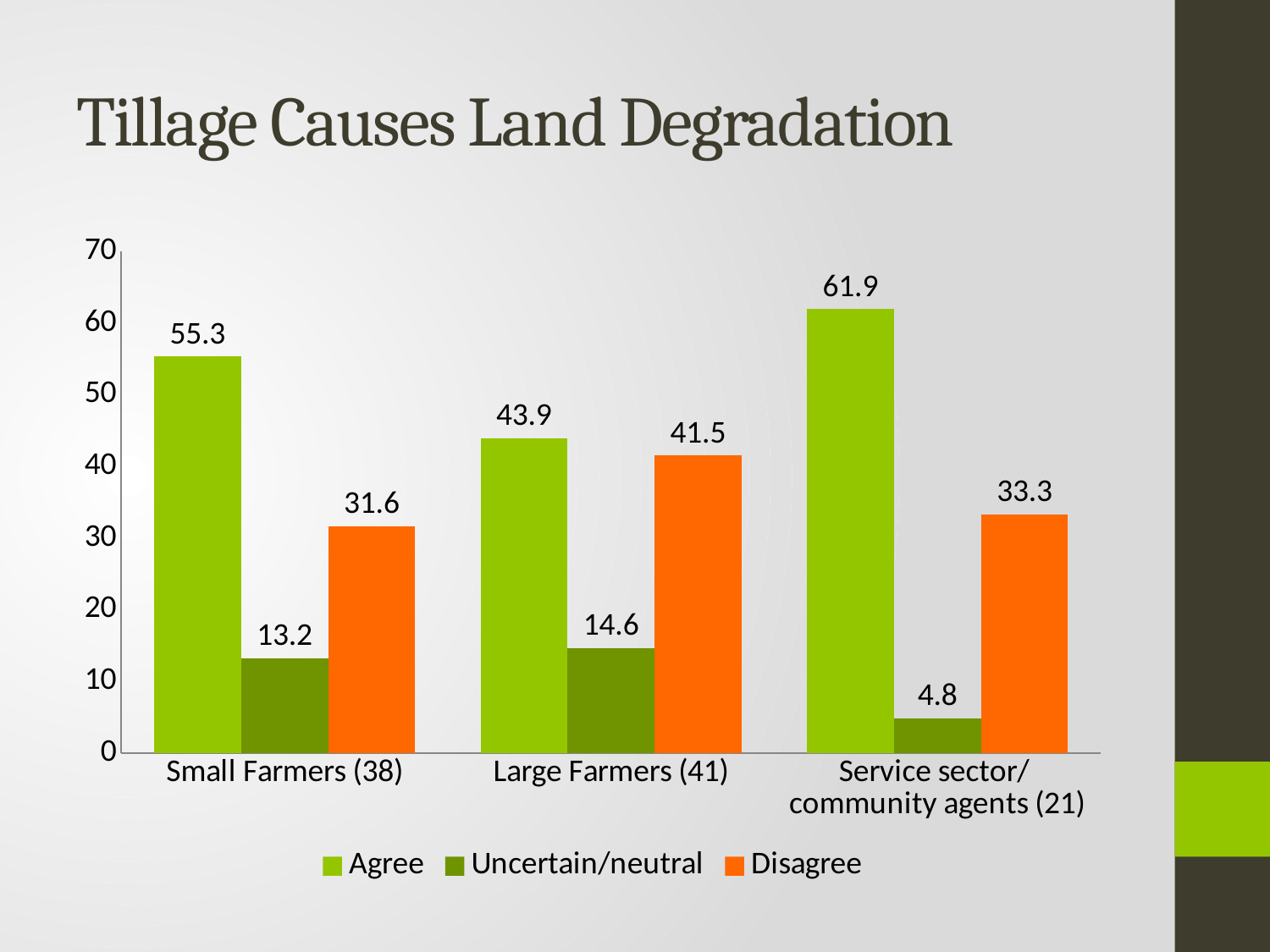
What is the Agree value for Small Farmers (38)? 55.3 How many categories are shown on the x axis? 3 Which category has the lowest Uncertain/neutral value? Service sector/community agents (21) How many series does the legend list? 3 What is the title of the chart? Tillage Causes Land Degradation Which is larger for Large Farmers (41): Agree or Disagree? Agree What kind of chart is shown on the slide? Bar chart What is the Uncertain/neutral value for Service sector/community agents (21)? 4.8 Is the Disagree value for Service sector/community agents (21) greater or less than 30? greater What is the difference between the Agree and Disagree values for Small Farmers (38)? 23.7 Which category has the highest Agree value? Service sector/community agents (21) What is the Disagree value for Large Farmers (41)? 41.5